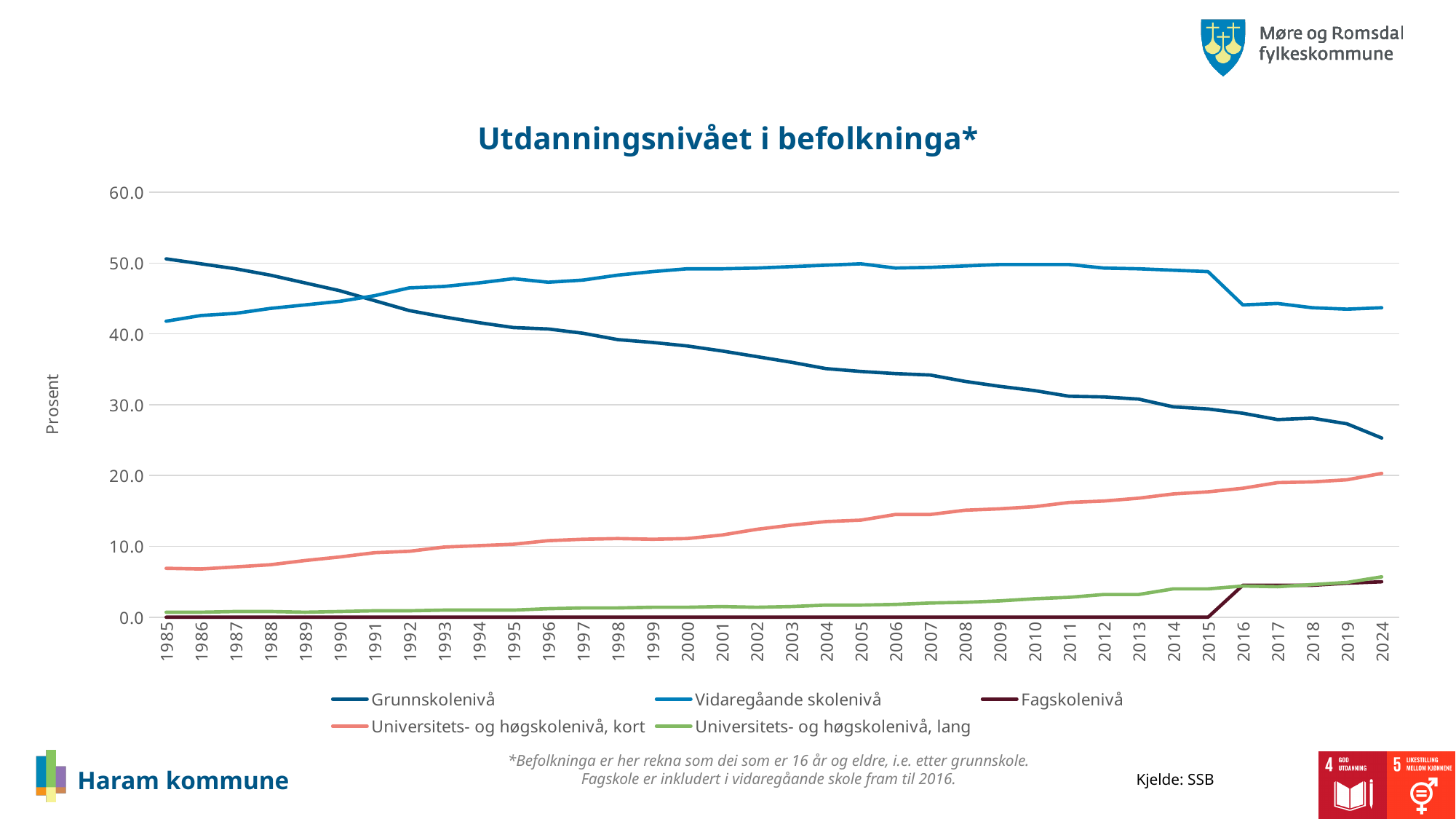
What kind of chart is shown on the slide? Line chart Is the value for Grunnskolenivå in 2024 greater or less than 30.0? less Does the value for Grunnskolenivå rise or fall from 1985 to 2024? Fall Does the value for Universitets- og høgskolenivå, kort rise or fall from 1985 to 2024? Rise How many series does the legend list? 5 How many years are shown along the x axis? 36 Which series has the lowest value in 1985? Fagskolenivå Is the value for Vidaregåande skolenivå in 2024 greater or less than 40.0? greater In 1985, which is larger: Grunnskolenivå or Vidaregåande skolenivå? Grunnskolenivå Which series has the highest value in 2024? Vidaregåande skolenivå What is the title of the chart? Utdanningsnivået i befolkninga* What is the label on the y axis? Prosent